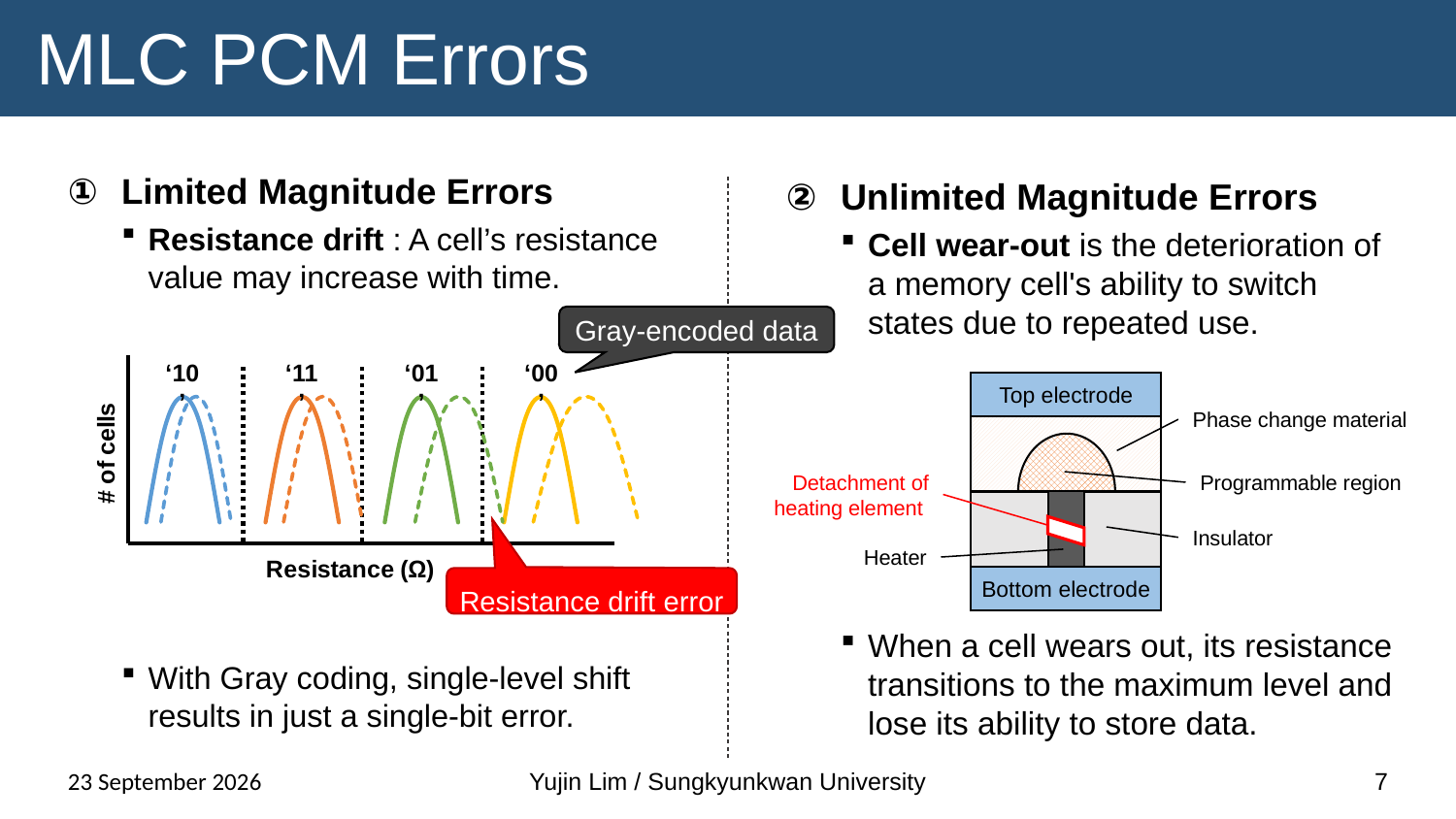
In the resistance distribution chart, is the resistance of level '00 higher or lower than that of level '10? higher In the resistance distribution chart, is the resistance of level '11 higher or lower than that of level '01? lower In the resistance distribution chart, which Gray-encoded level sits at the highest resistance? '00 What is the label of the x axis of the resistance distribution chart? Resistance (Ω) What kind of chart is used to show the cell resistance distributions on the left of the slide? line chart How many Gray-encoded resistance levels are shown in the '# of cells' versus 'Resistance (Ω)' chart? 4 In the resistance distribution chart, in which direction do the dashed curves shift relative to the solid curves along the x axis? to higher resistance In the resistance distribution chart, which Gray-encoded level sits at the lowest resistance? '10 What is the label of the y axis of the resistance distribution chart? # of cells